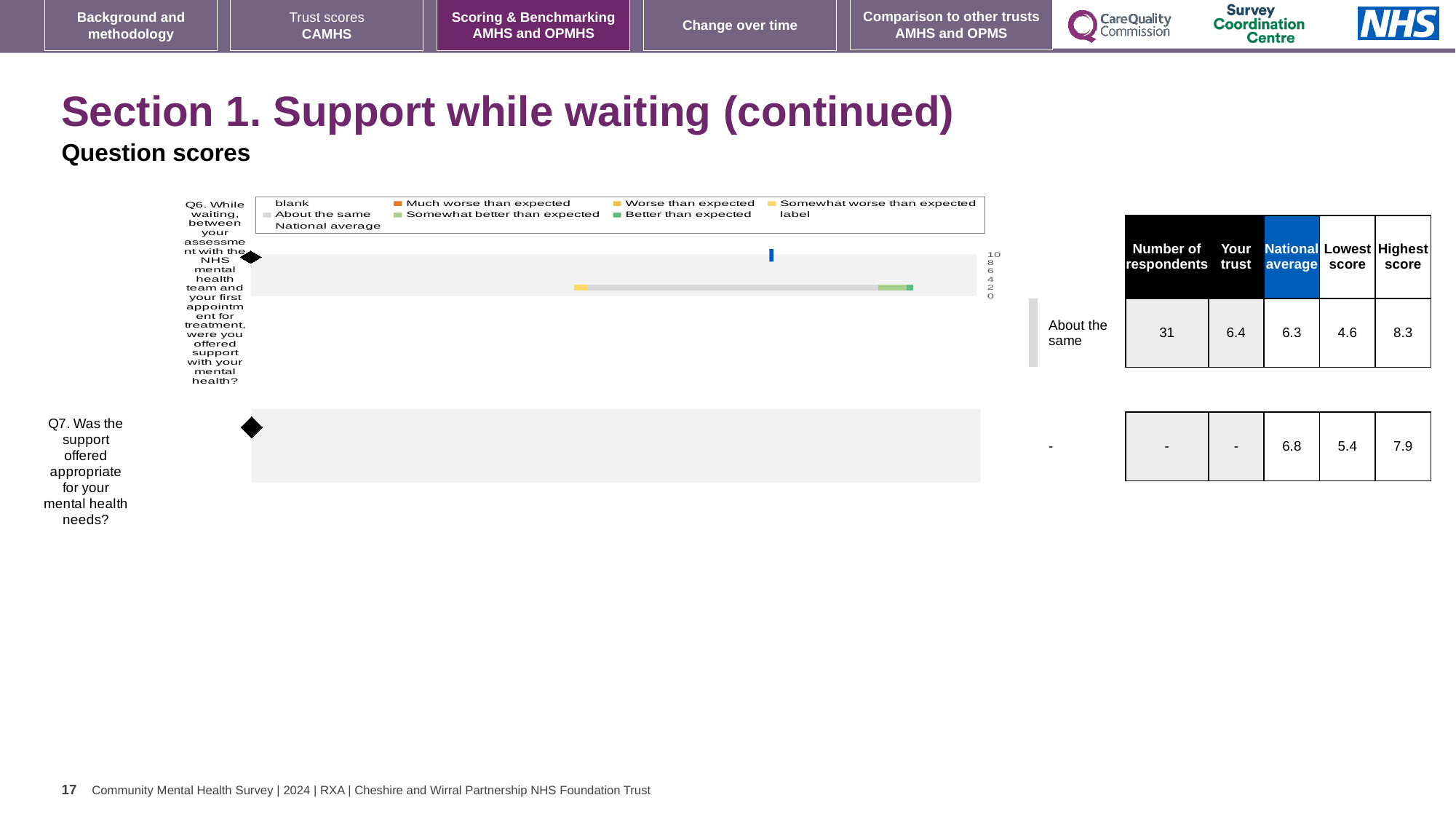
What is the national average score for Q6? 6.3 What is the 'Your trust' score for Q6? 6.4 Which is larger for Q6, the 'Your trust' score or the national average? Your trust What colour is the legend marker for 'Much worse than expected' in the Q6 chart? orange What kind of chart is used to show the Q6 question score? bar chart What is the difference between the highest score and the lowest score for Q6? 3.7 How many entries does the legend of the Q6 chart list? 9 How many respondents are listed for Q6 in the table? 31 What is the highest tick value shown on the axis of the Q6 chart? 10 What is the national average score for Q7? 6.8 Which benchmark category is shown next to the Q6 chart? About the same